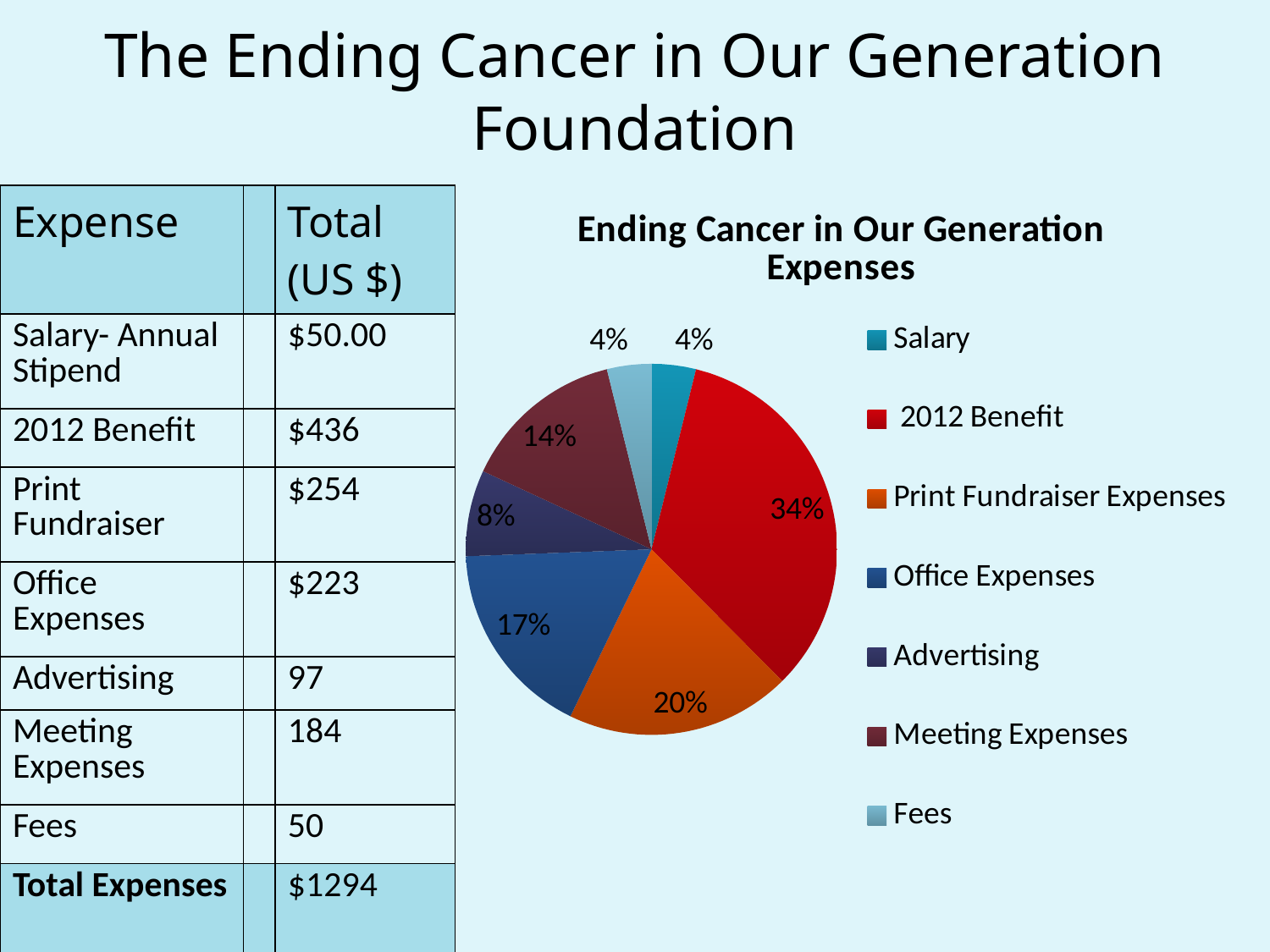
How many categories does the pie chart's legend list? 7 What percentage is shown for Meeting Expenses in the pie chart? 14% What share of the pie does 2012 Benefit represent? 34% What is the difference in percentage points between the 2012 Benefit slice and the Print Fundraiser Expenses slice? 14 What is the title of the pie chart? Ending Cancer in Our Generation Expenses Which slice is larger in the pie chart, Office Expenses or Meeting Expenses? Office Expenses What percentage is shown for Print Fundraiser Expenses in the pie chart? 20% What kind of chart is shown on the slide? pie chart Which legend entry is shown in red in the pie chart? 2012 Benefit What percentage is shown for Office Expenses in the pie chart? 17% What percentage is shown for Advertising in the pie chart? 8% Which category has the largest slice of the pie chart? 2012 Benefit